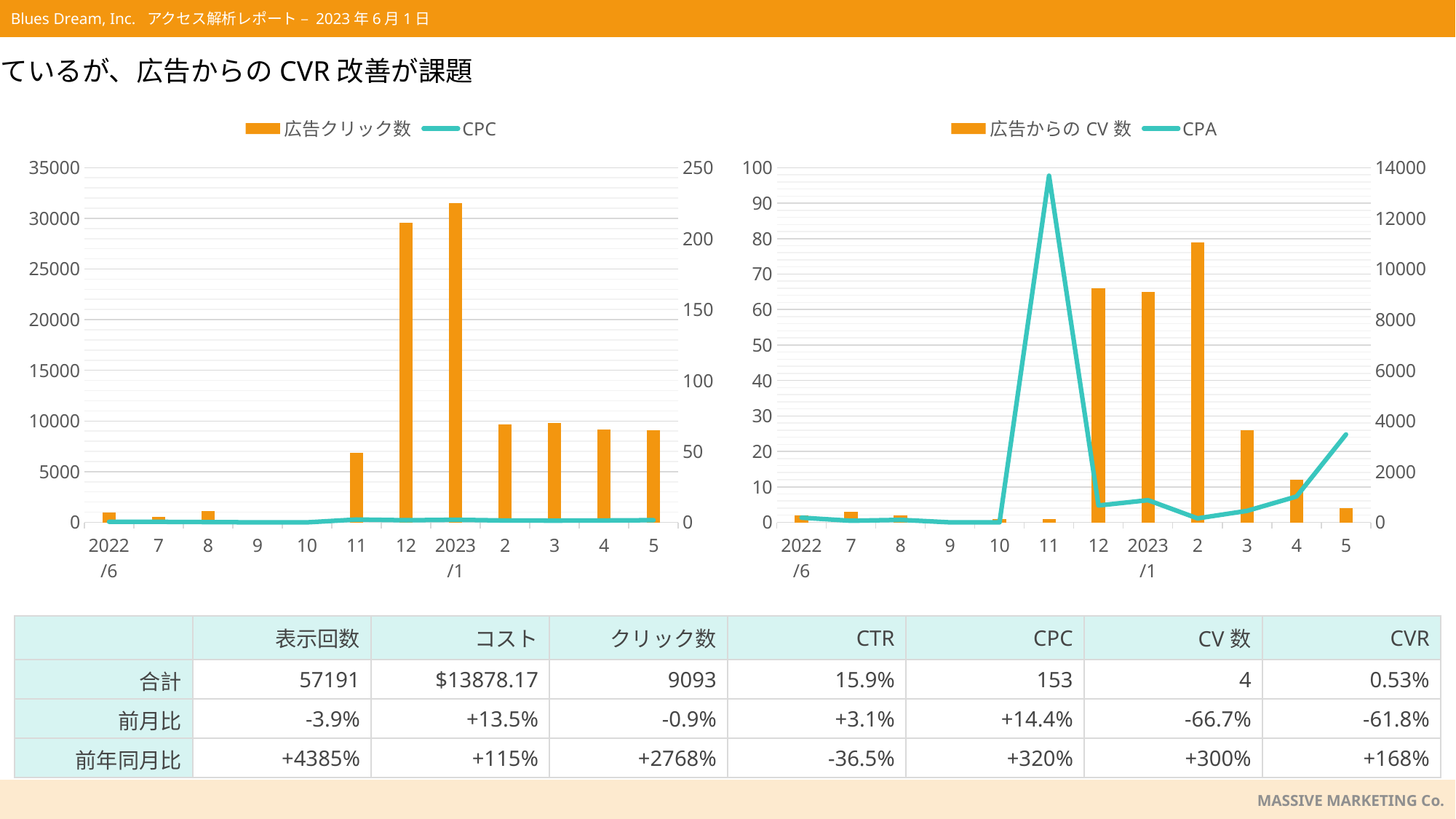
In the right chart, is the CPA value for 11 (2022) greater or less than 12000? greater In the left chart, is the 広告クリック数 value for 2023/1 greater or less than 30000? greater How many months are plotted along the x axis of the left chart (広告クリック数 / CPC)? 12 In the right chart, in which month does the CPA line reach its peak? 11 In the right chart, is the 広告からの CV 数 value for 2 (2023) greater or less than 70? greater What kind of chart is the left chart with the 広告クリック数 legend? Combined bar and line chart In the left chart, which is larger, the 広告クリック数 bar for 12 (2022) or for 2023/1? 2023/1 In the right chart, which month has the highest 広告からの CV 数 bar? 2 In the right chart, does the CPA line rise or fall from 2023/2 to 5? rise How many series does the legend of the right chart (広告からの CV 数 / CPA) list? 2 In the left chart, which month has the highest 広告クリック数 bar? 2023/1